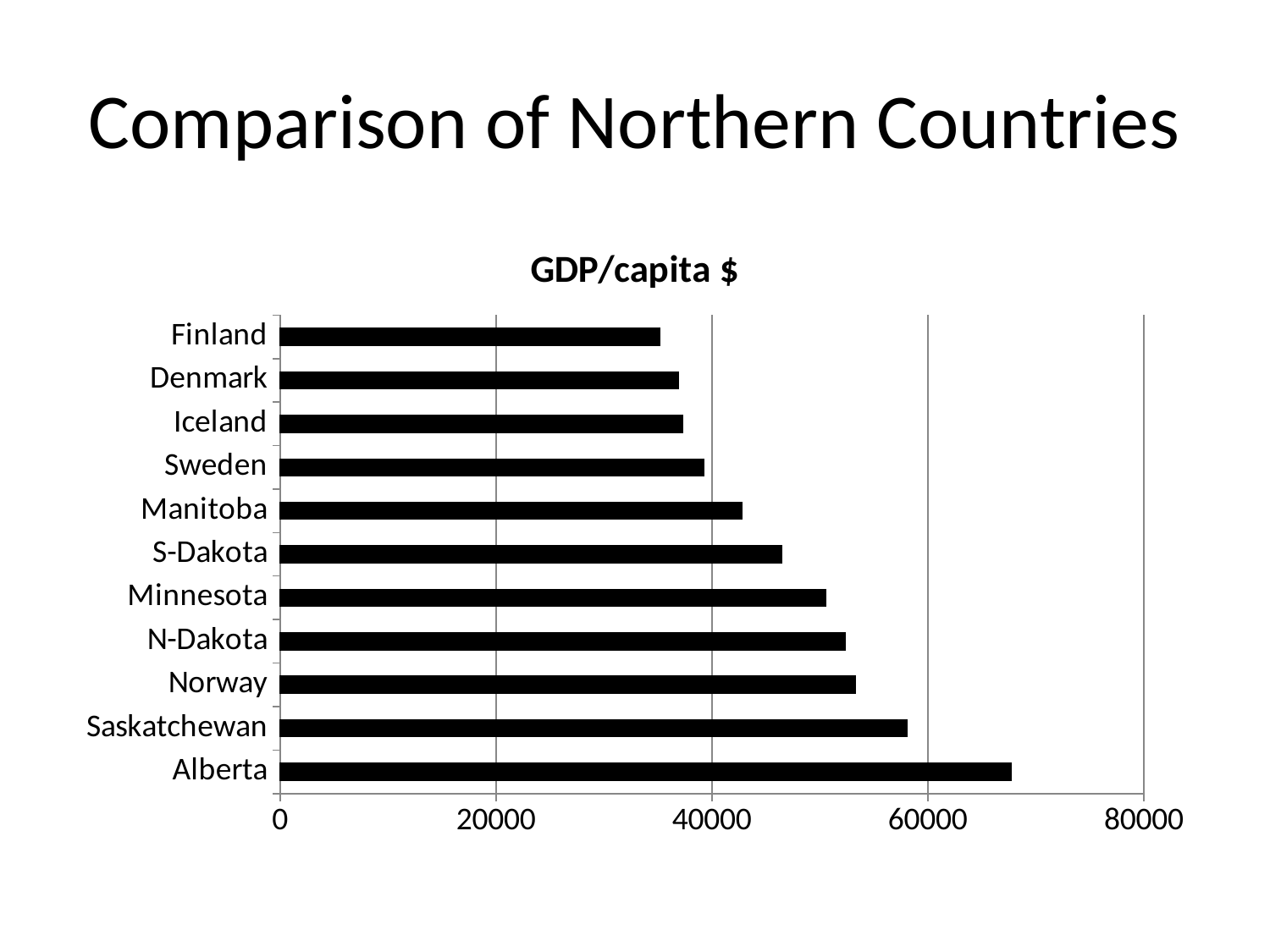
Which country or region has the highest GDP/capita in the chart? Alberta Which has a higher GDP/capita, Alberta or Norway? Alberta Which has a higher GDP/capita, Manitoba or Sweden? Manitoba Which country or region has the lowest GDP/capita in the chart? Finland What is the title of the chart? GDP/capita $ Is the value for Alberta greater or less than 60000? greater Is the value for Saskatchewan greater or less than 60000? less Is the value for Finland greater or less than 40000? less What colour are the bars in the chart? black How many countries or regions are plotted in the chart? 11 What kind of chart is shown on the slide? bar chart